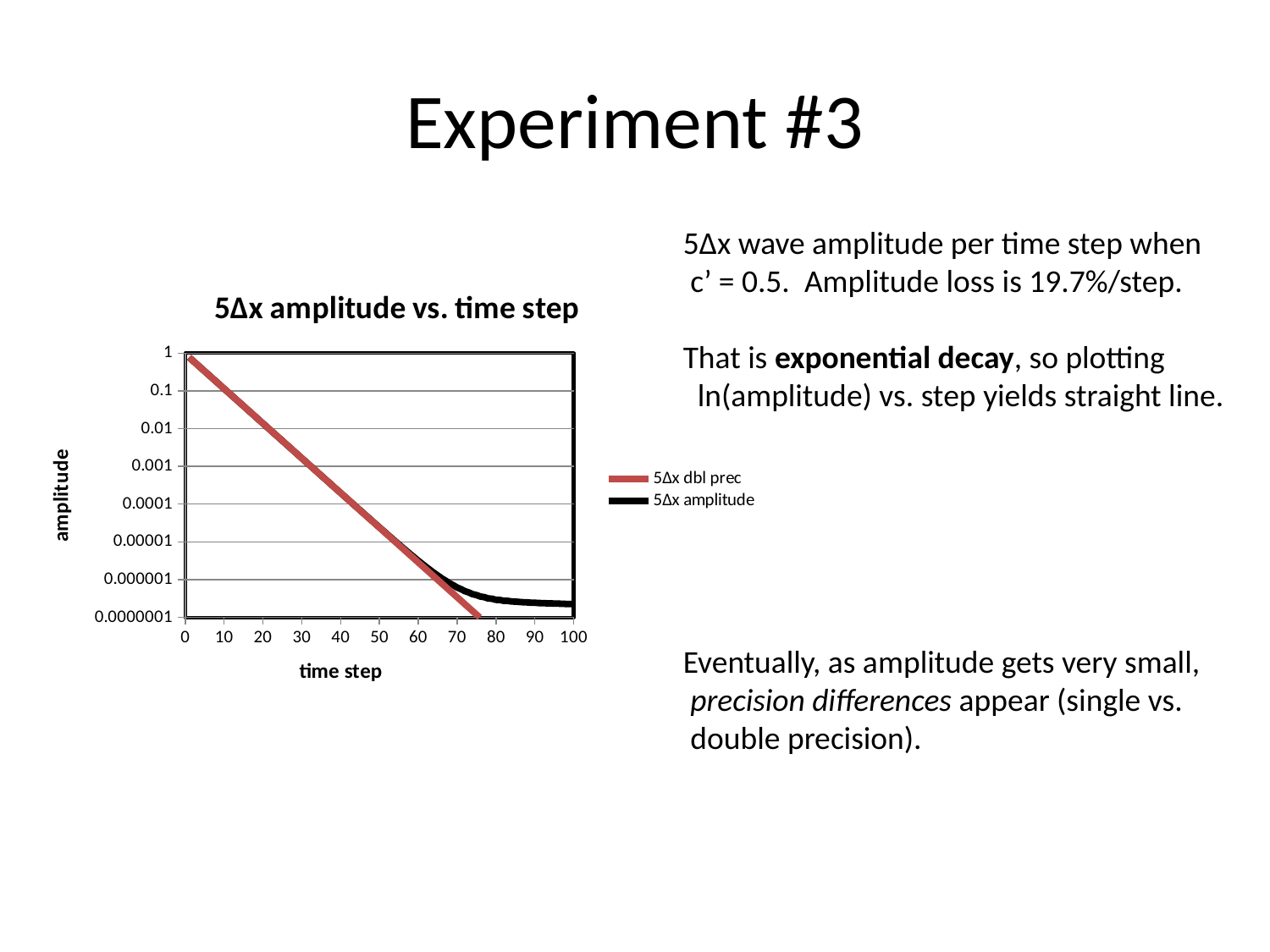
What is the title of the chart? 5Δx amplitude vs. time step Is the value of 5Δx amplitude at time step 100 greater or less than 0.000001? less What is the highest value labelled on the amplitude axis? 1 Is the value of 5Δx dbl prec at time step 20 greater or less than 0.1? less What kind of chart is shown on the slide? line chart Which series is drawn in red in the chart? 5Δx dbl prec How many tick labels are shown on the time step axis? 11 Do the amplitude values rise or fall as the time step increases? fall Which series flattens out at small amplitudes instead of continuing to decrease, 5Δx dbl prec or 5Δx amplitude? 5Δx amplitude How many series does the chart legend list? 2 Is the value of 5Δx dbl prec at time step 40 greater or less than 0.001? less